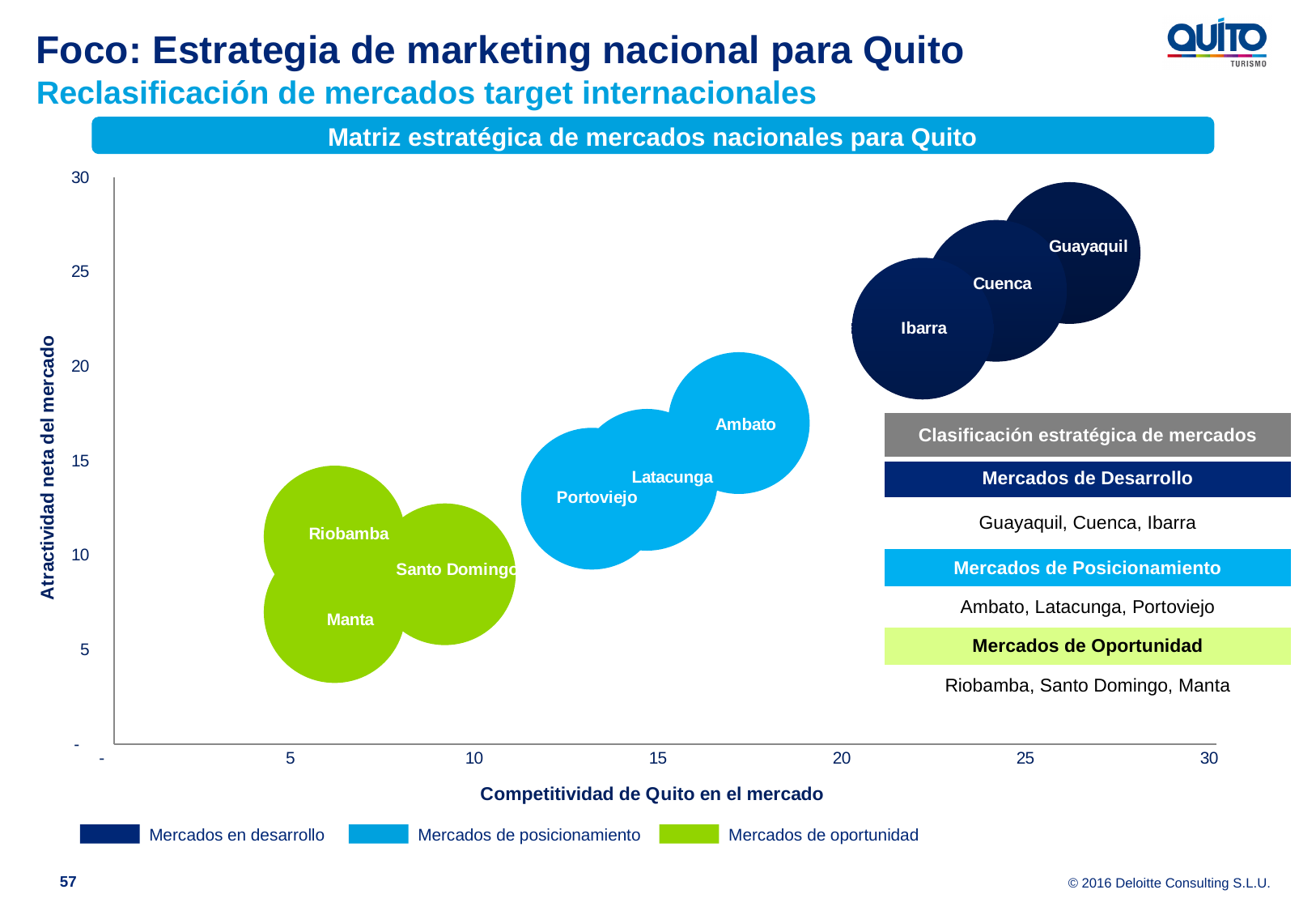
Which market has the highest value on the 'Atractividad neta del mercado' axis? Guayaquil How many series does the legend below the chart list? 3 How many markets (bubbles) are plotted on the chart? 9 What is the title of the chart? Matriz estratégica de mercados nacionales para Quito Is the 'Competitividad de Quito en el mercado' value for Guayaquil greater or less than 25? greater Is the 'Competitividad de Quito en el mercado' value for Riobamba greater or less than 10? less Which market has the highest value on the 'Competitividad de Quito en el mercado' axis? Guayaquil Is the 'Atractividad neta del mercado' value for Ambato greater or less than 20? less Which market has the lowest value on the 'Atractividad neta del mercado' axis? Manta What kind of chart is shown on the slide? Bubble chart Which has a higher 'Atractividad neta del mercado' value, Ibarra or Ambato? Ibarra